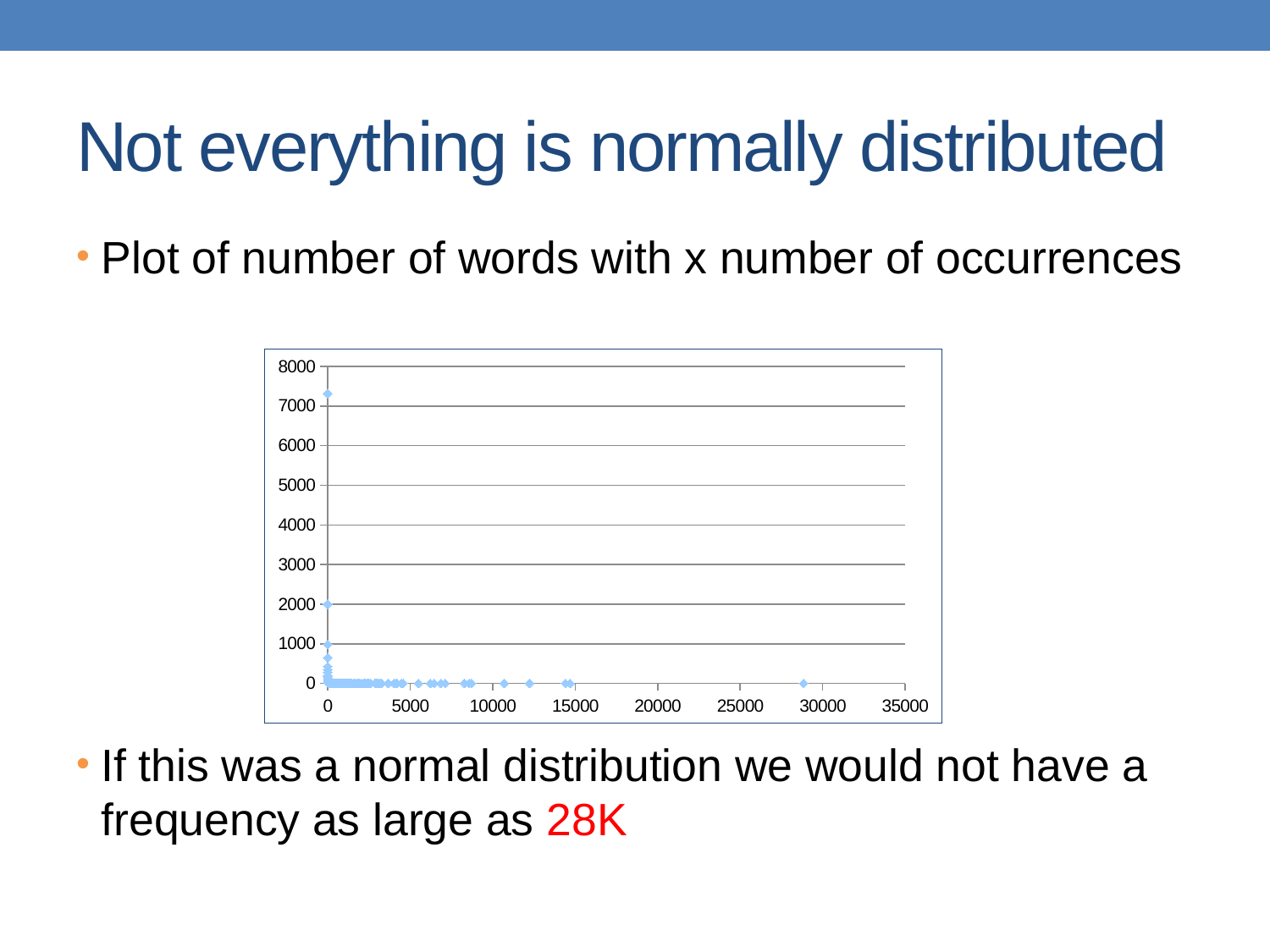
Is the highest plotted value on the chart greater or less than 7000? greater What is the highest tick value shown on the y axis of the chart? 8000 Is the x position of the rightmost point on the chart greater or less than 30000? less Is the x position of the rightmost point on the chart greater or less than 25000? greater Do the plotted values generally rise or fall as the x value increases? fall What kind of chart is shown on the slide? scatter plot What is the highest tick value shown on the x axis of the chart? 35000 Are the points with the largest y values located near the left or the right end of the x axis? left